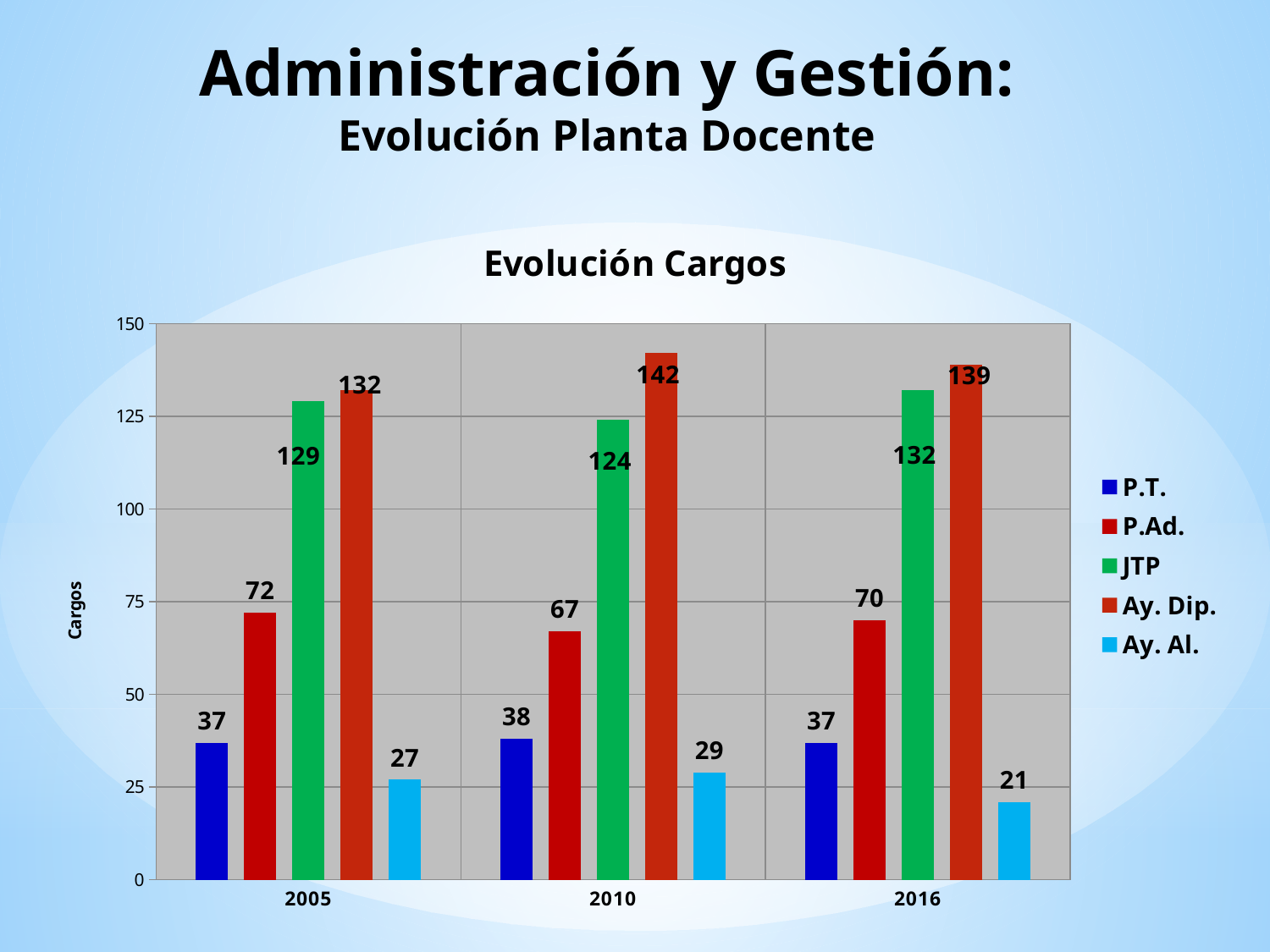
What is the difference between the P.Ad. values in 2005 and 2016? 2 What is the title of the chart? Evolución Cargos How many series does the legend list? 5 Which year has the highest value for Ay. Dip.? 2010 What is the value for Ay. Dip. in 2010? 142 What is the value for Ay. Al. in 2016? 21 What is the value for JTP in 2005? 129 Which is larger, the JTP value in 2010 or the JTP value in 2016? 2016 How many years are shown on the x axis? 3 What kind of chart is shown? Bar chart Which series has the lowest value in 2016? Ay. Al. Does the value for Ay. Al. rise or fall from 2010 to 2016? Fall